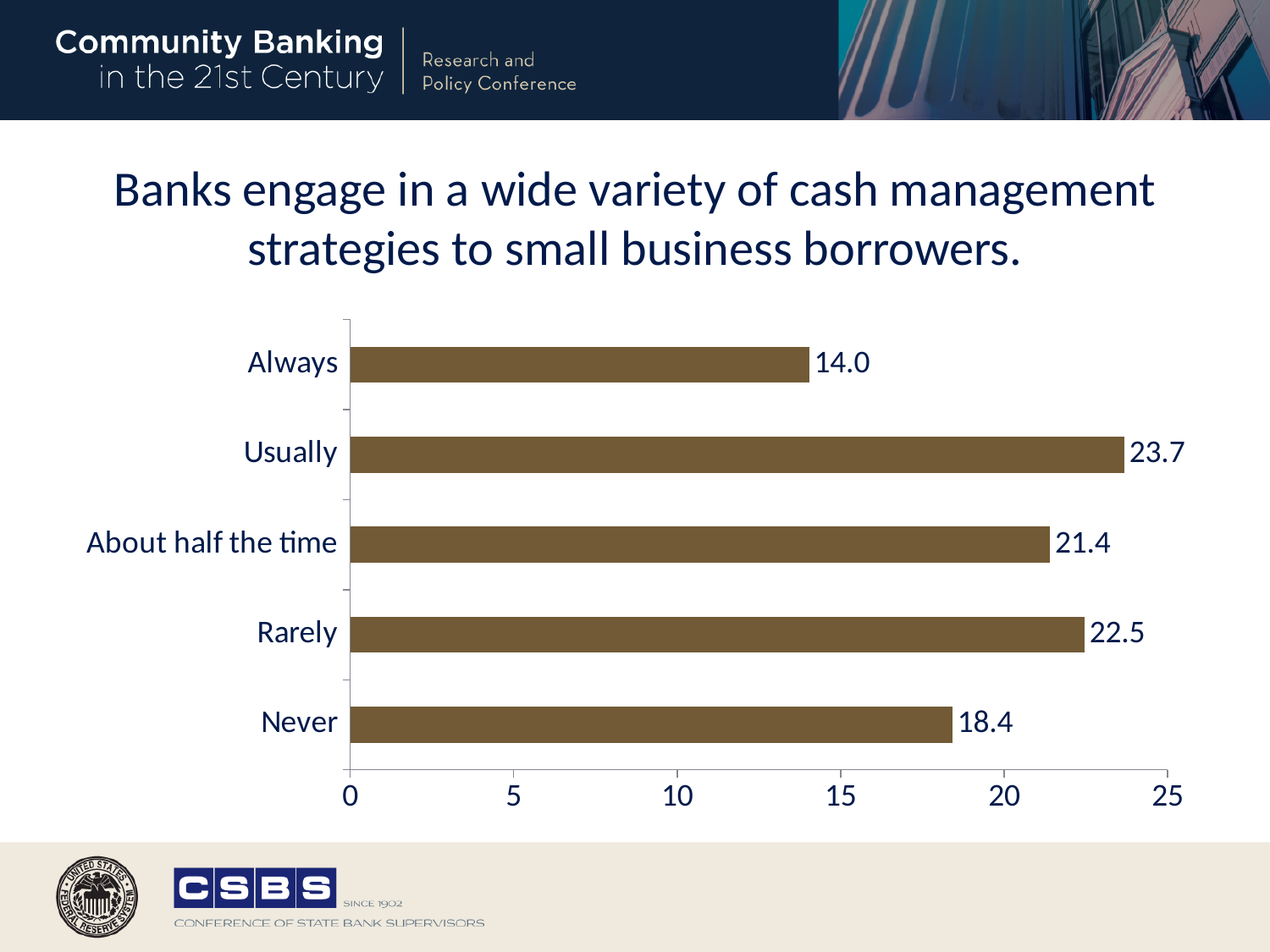
Which category has the lowest value? Always What is the difference between the values for Rarely and Never? 4.1 Is the value for Never greater or less than 20? less What kind of chart is shown on the slide? bar chart What is the value for Usually? 23.7 What is the value for About half the time? 21.4 What is the value for Always? 14.0 Which category has the highest value? Usually Which is larger, the value for Rarely or the value for About half the time? Rarely How many categories are shown in the chart? 5 What is the difference between the values for Usually and Always? 9.7 What is the value for Never? 18.4